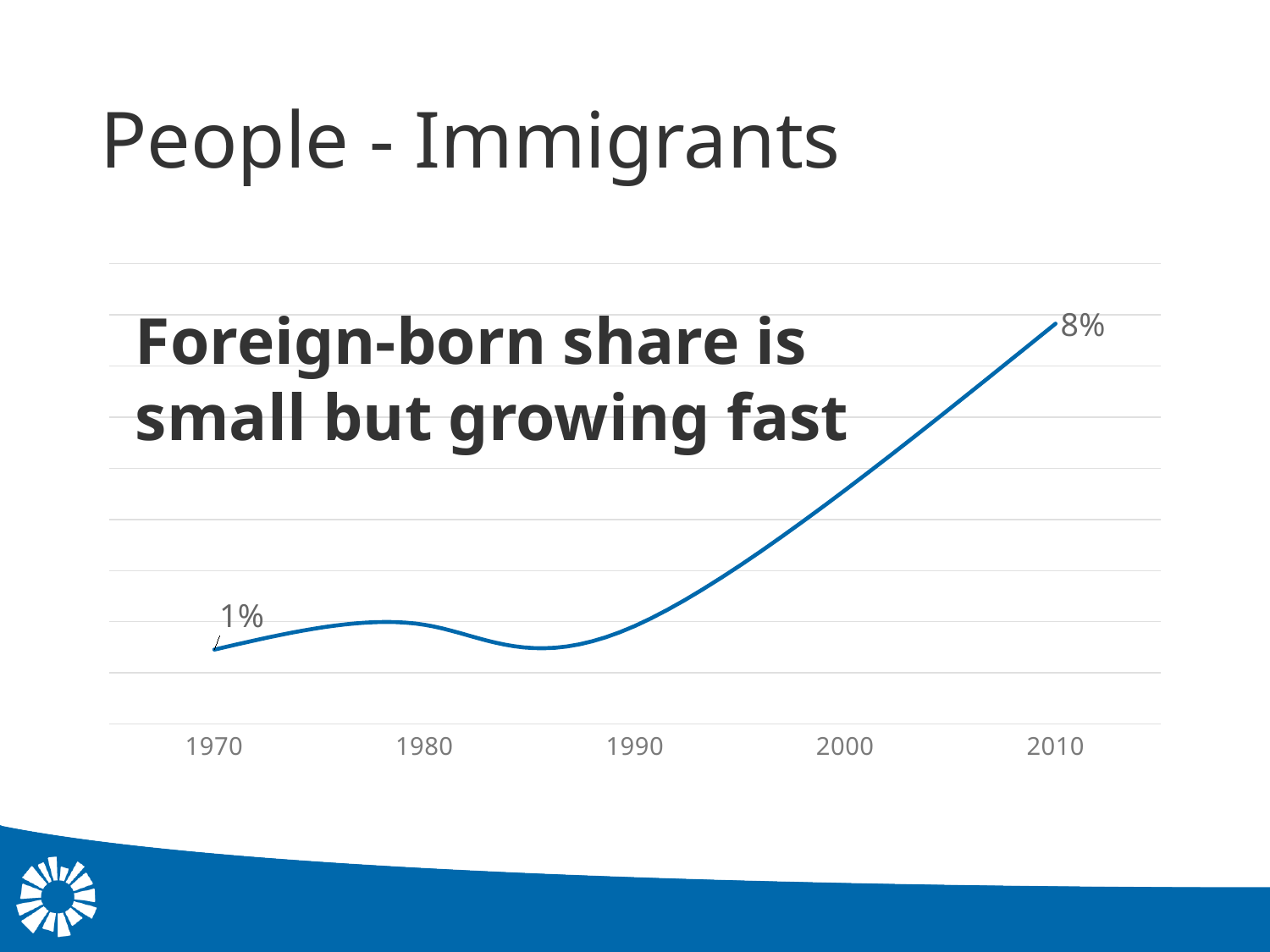
What is the headline text written over the chart? Foreign-born share is small but growing fast What is the first year labelled on the x axis? 1970 What kind of chart is shown on the slide? Line chart By how many percentage points did the foreign-born share rise from 1970 to 2010? 7 percentage points Does the foreign-born share rise or fall between 1990 and 2010? Rise Which labelled year has the highest foreign-born share? 2010 What is the foreign-born share shown for 2010? 8% What is the foreign-born share shown for 1970? 1% Which year has the higher foreign-born share, 1970 or 2010? 2010 How many year labels are shown on the x axis? 5